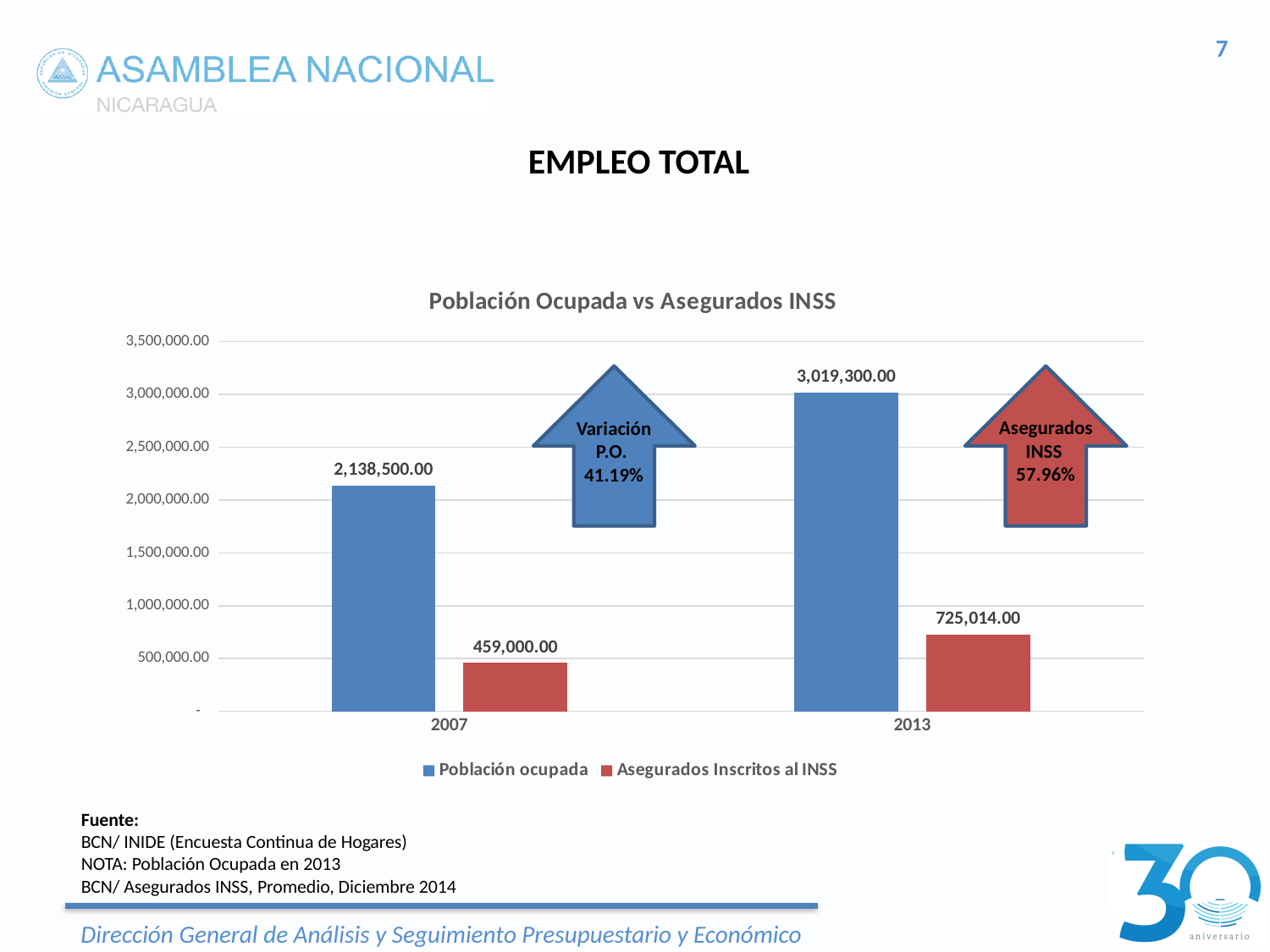
What is the value of Población ocupada for 2007? 2,138,500.00 What kind of chart is shown on the slide? Bar chart Which year has the higher value for Población ocupada? 2013 What is the difference between Asegurados Inscritos al INSS in 2013 and in 2007? 266,014.00 What is the difference between Población ocupada in 2013 and in 2007? 880,800.00 What is the title of the chart? Población Ocupada vs Asegurados INSS Is the value for Asegurados Inscritos al INSS in 2013 greater or less than 1,000,000.00? less What is the value of Asegurados Inscritos al INSS for 2013? 725,014.00 What is the value of Población ocupada for 2013? 3,019,300.00 Which bar in the chart has the lowest value? Asegurados Inscritos al INSS in 2007 What is the value of Asegurados Inscritos al INSS for 2007? 459,000.00 How many series does the legend list? 2